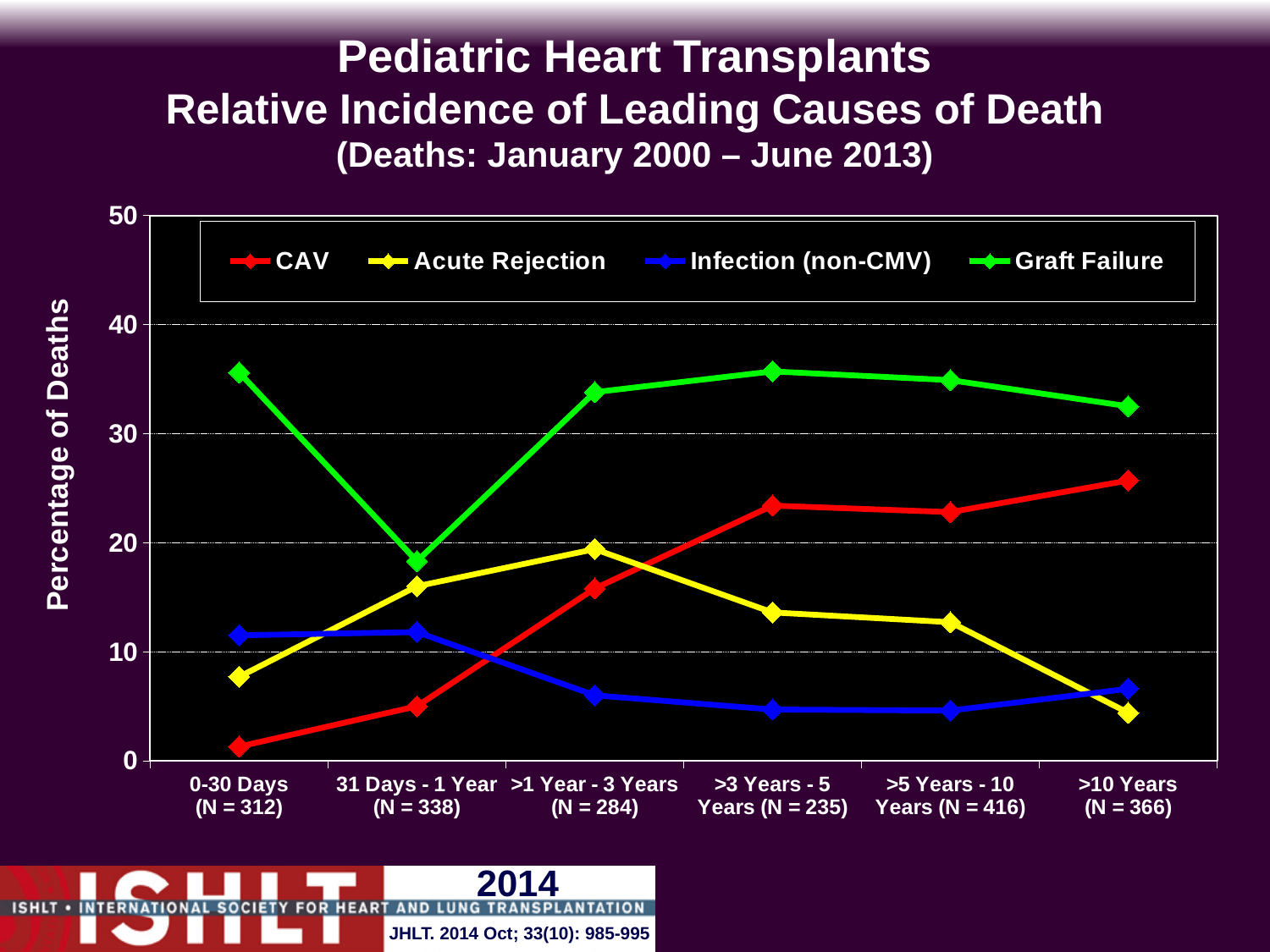
Which cause of death has the highest percentage at >3 Years - 5 Years? Graft Failure Does the CAV line generally rise or fall from 0-30 Days to >10 Years? rise Is the value for Acute Rejection at >10 Years greater or less than 10? less What kind of chart is shown on the slide? line chart Which cause of death has the lowest percentage at 0-30 Days? CAV Is the value for Graft Failure at 0-30 Days greater or less than 30? greater At 31 Days - 1 Year, which is larger: Acute Rejection or Infection (non-CMV)? Acute Rejection How many time-period categories are shown on the x axis? 6 In which time period is the Graft Failure percentage lowest? 31 Days - 1 Year How many series does the legend list? 4 What is the title of the y axis? Percentage of Deaths Is the value for CAV at 0-30 Days greater or less than 10? less